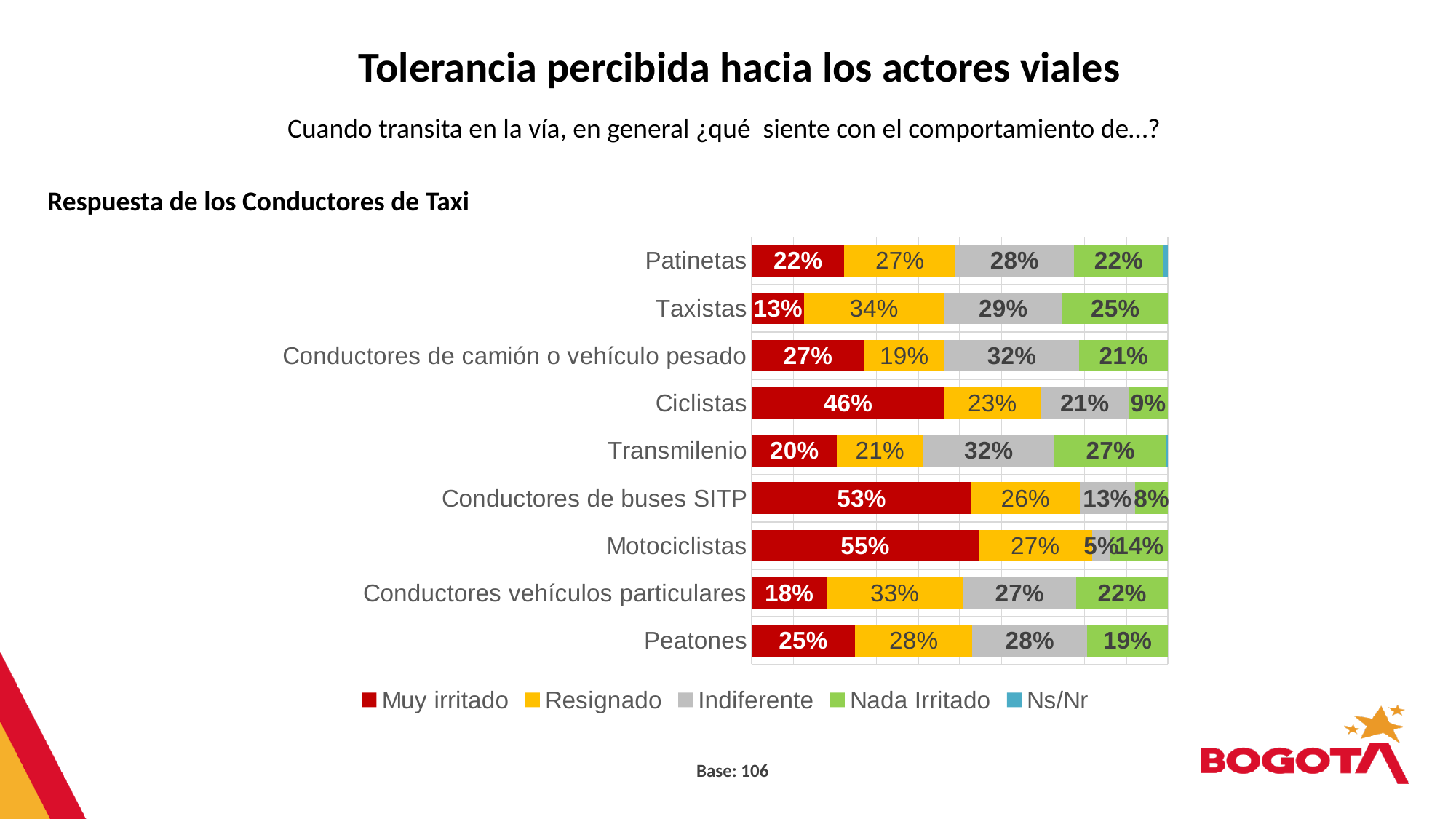
What percentage of taxi drivers are 'Muy irritado' with Ciclistas? 46% Which colour represents 'Nada Irritado' in the chart? Green What is the 'Indiferente' value for Transmilenio? 32% What is the difference between the 'Muy irritado' values for Conductores de buses SITP and Ciclistas? 7% How many series does the legend list? 5 Which category has the highest 'Muy irritado' percentage? Motociclistas What is the 'Resignado' value for Taxistas? 34% What type of chart is shown on the slide? Stacked bar chart Which is larger: the 'Resignado' value for Conductores vehículos particulares or for Conductores de camión o vehículo pesado? Conductores vehículos particulares What is the 'Nada Irritado' value for Peatones? 19% Which category has the lowest 'Muy irritado' percentage? Taxistas How many road actor categories are shown in the chart? 9